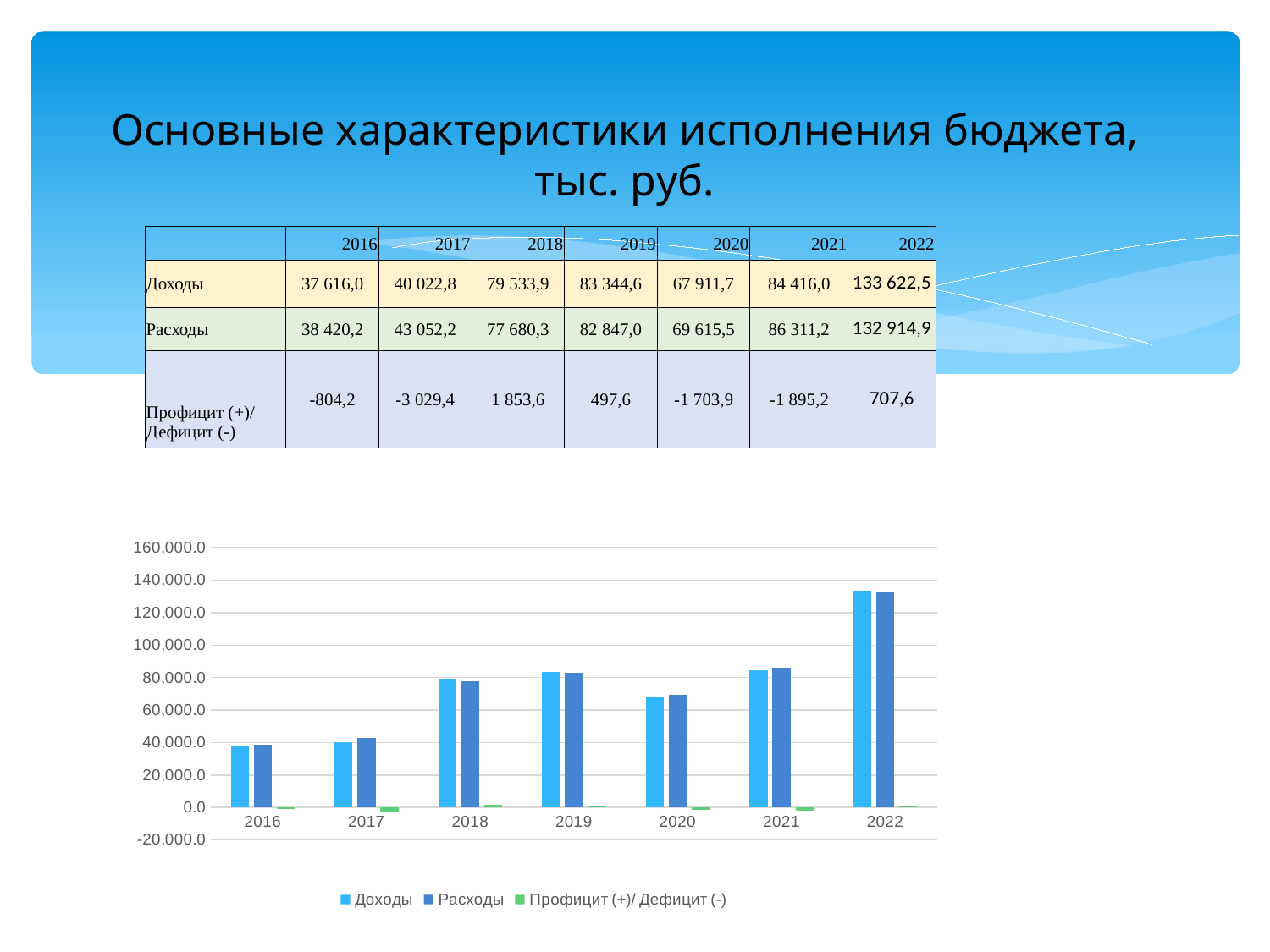
In which year is the Доходы bar the highest? 2022 What are the three entries in the chart legend? Доходы, Расходы, Профицит (+)/ Дефицит (-) Is the value for Доходы in 2020 greater or less than 80,000.0? less What type of chart is shown on the slide? bar chart In 2017, which is larger, Доходы or Расходы? Расходы According to the table on the slide, what is the value of Профицит (+)/ Дефицит (-) for 2017? -3 029,4 According to the table on the slide, what is the value of Доходы for 2022? 133 622,5 Is the value for Доходы in 2022 greater or less than 120,000.0? greater Do the Доходы values rise or fall from 2016 to 2019? rise In which year is the Доходы bar the lowest? 2016 How many series does the chart legend list? 3 How many years are shown on the x axis of the chart? 7